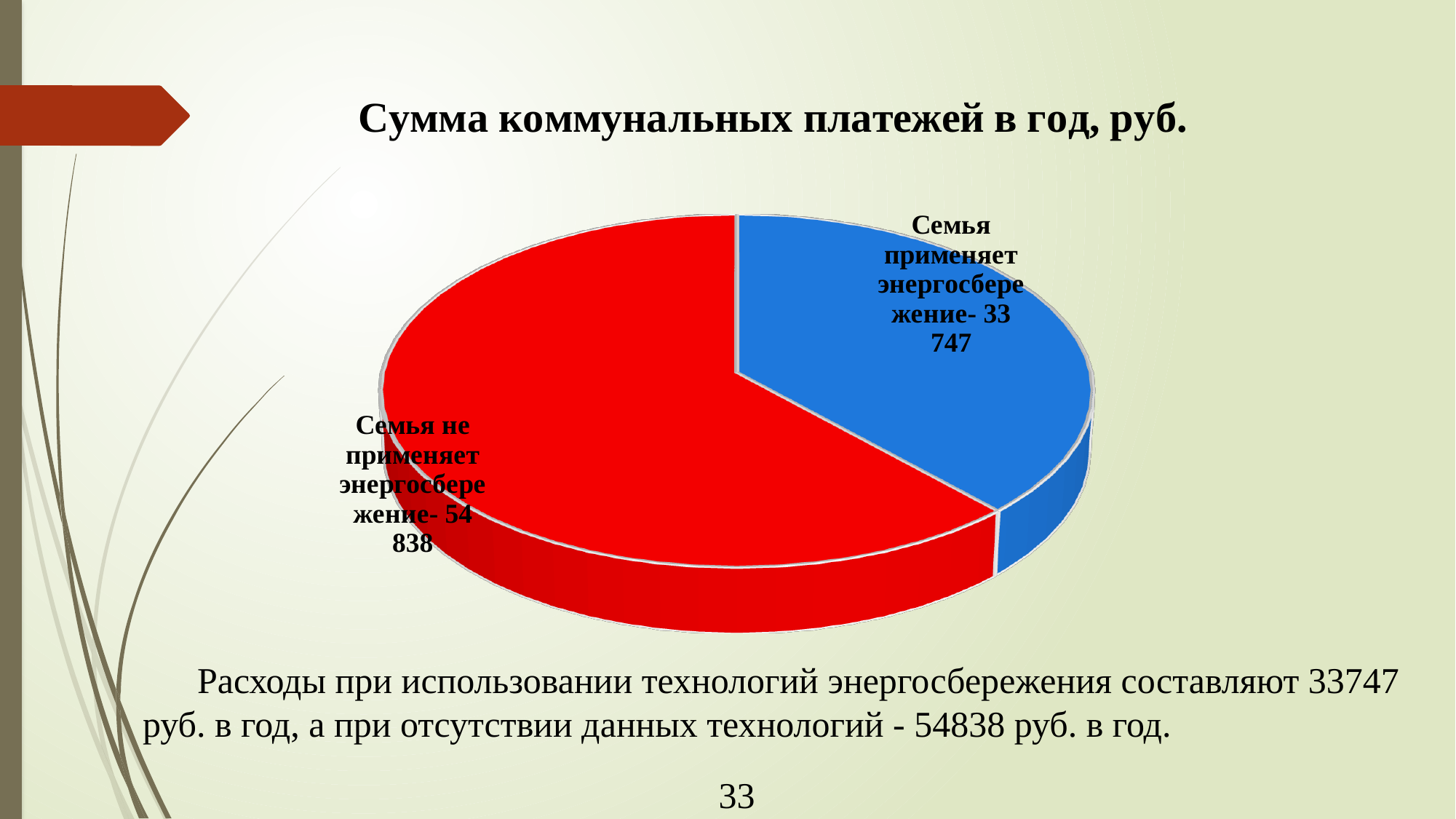
What kind of chart is shown on the slide? Pie chart Which category has the highest value in the pie chart? Семья не применяет энергосбережение What colour is the slice for 'Семья не применяет энергосбережение'? Red Which category has the lowest value in the pie chart? Семья применяет энергосбережение What is the value for the slice 'Семья применяет энергосбережение'? 33 747 What is the difference between the value for 'Семья не применяет энергосбережение' and the value for 'Семья применяет энергосбережение'? 21 091 What is the value for the slice 'Семья не применяет энергосбережение'? 54 838 How many slices does the pie chart have? 2 What is the title of the chart? Сумма коммунальных платежей в год, руб. What is the total of the two values shown in the pie chart? 88 585 Which is larger: the value for 'Семья применяет энергосбережение' or the value for 'Семья не применяет энергосбережение'? Семья не применяет энергосбережение